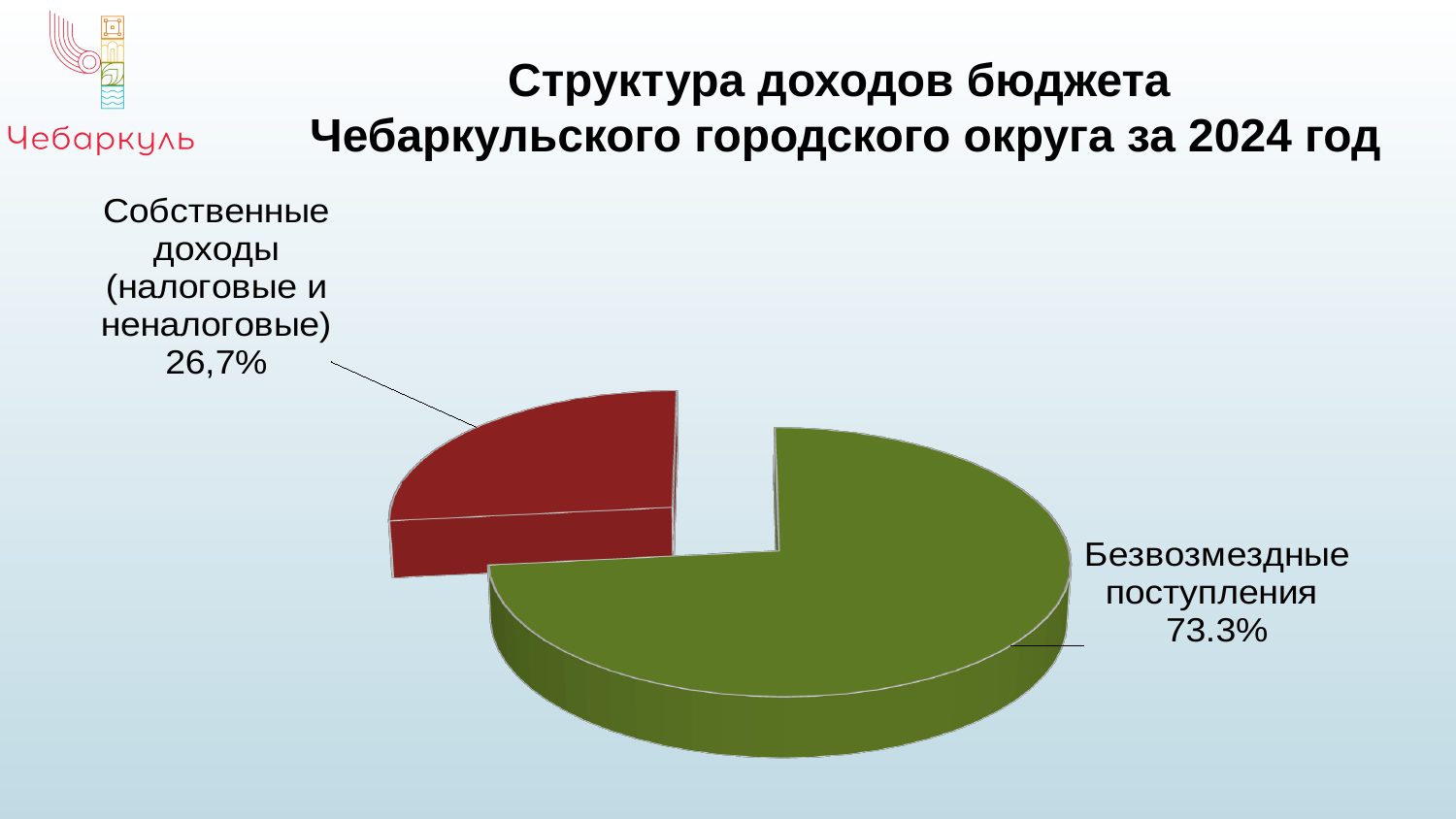
Is the share for "Собственные доходы (налоговые и неналоговые)" greater or less than 50%? less What colour is the slice for "Безвозмездные поступления"? Green What is the title of the chart on the slide? Структура доходов бюджета Чебаркульского городского округа за 2024 год Is the share for "Безвозмездные поступления" greater or less than 70%? greater Which is larger: the share for "Безвозмездные поступления" or the share for "Собственные доходы (налоговые и неналоговые)"? Безвозмездные поступления Which slice of the pie is the largest? Безвозмездные поступления What share of the pie is labelled for "Собственные доходы (налоговые и неналоговые)"? 26,7% Which slice of the pie is the smallest? Собственные доходы (налоговые и неналоговые) What share of the pie is labelled for "Безвозмездные поступления"? 73.3% How many slices does the pie chart have? 2 What kind of chart is shown on the slide? Pie chart